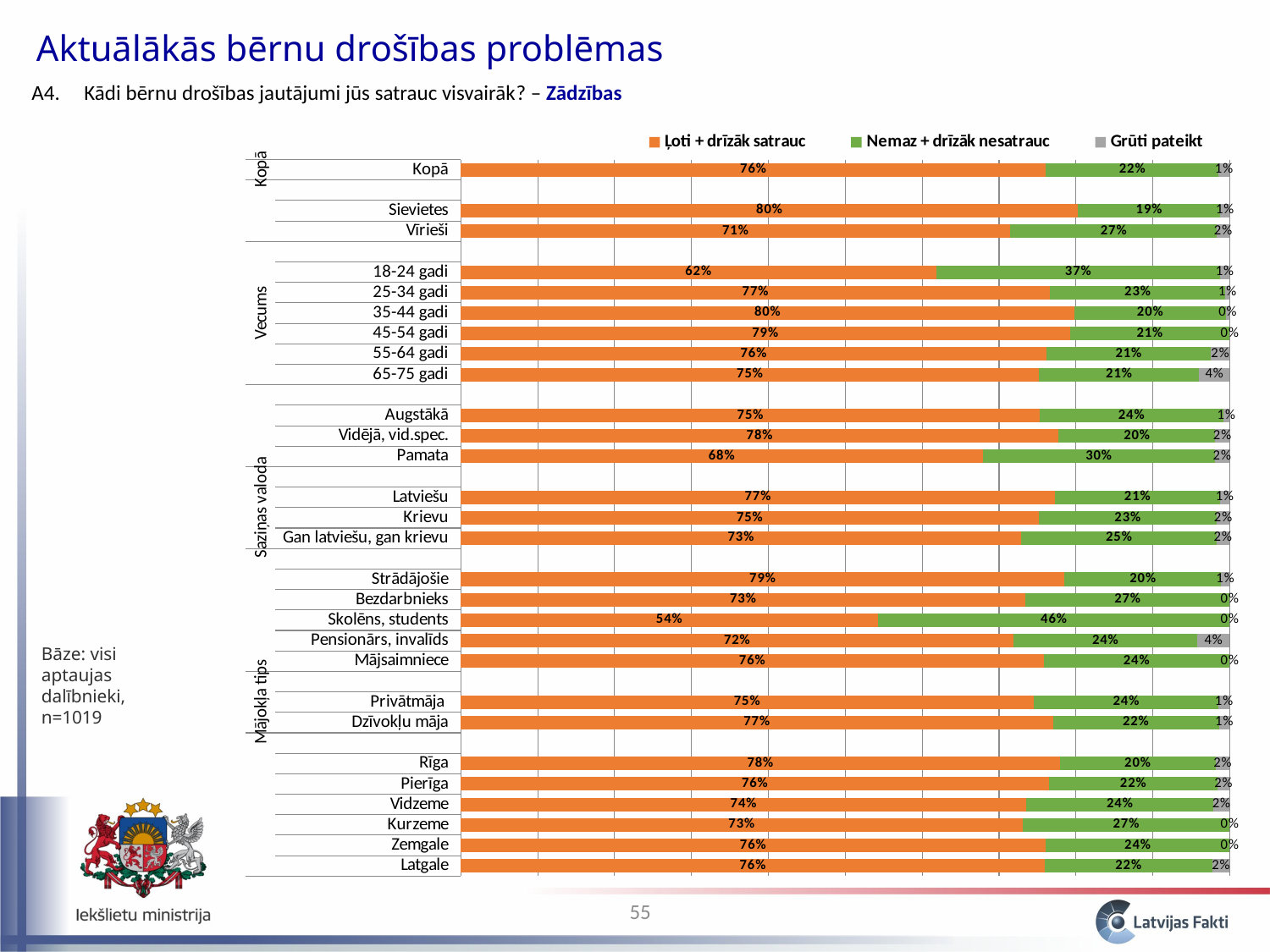
What is the total of the stacked bar for the 65-75 gadi group? 100% Which has a larger "Ļoti + drīzāk satrauc" value, Rīga or Latgale? Rīga Which category has the lowest "Ļoti + drīzāk satrauc" value? Skolēns, students What is the "Nemaz + drīzāk nesatrauc" value for the 18-24 gadi group? 37% Which category has the highest "Nemaz + drīzāk nesatrauc" value? Skolēns, students What kind of chart is shown on the slide? Stacked bar chart What is the difference in the "Ļoti + drīzāk satrauc" value between Sievietes and Vīrieši? 9 percentage points What is the "Grūti pateikt" value for the 65-75 gadi group? 4% How many series does the legend list? 3 What percentage of all respondents (Kopā) answered "Ļoti + drīzāk satrauc"? 76% Which colour represents the "Grūti pateikt" series? Grey Which has a larger "Nemaz + drīzāk nesatrauc" value, Pamata or Augstākā? Pamata